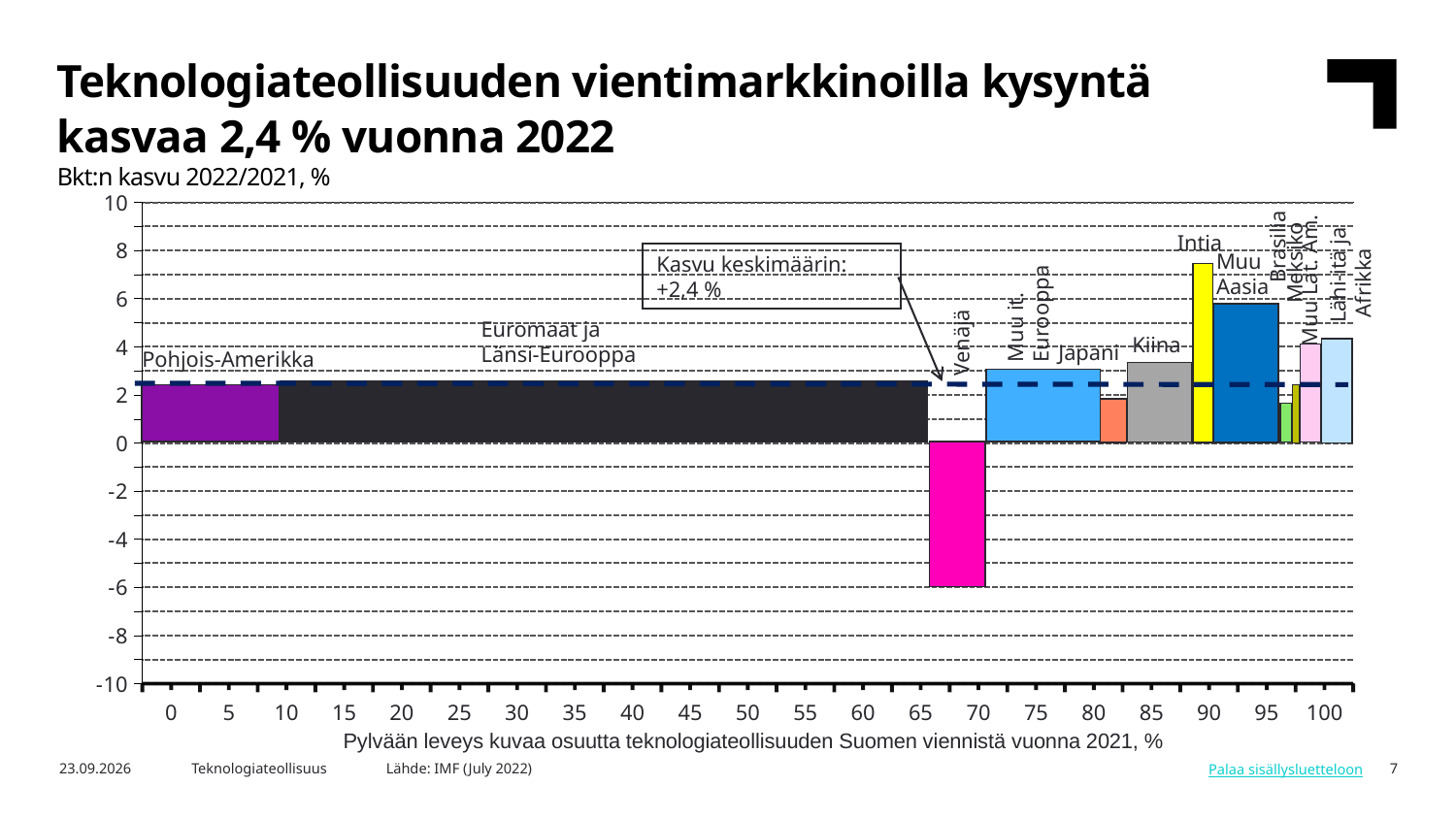
Is the value for Kiina greater or less than 4? less Is the value for Intia greater or less than 6? greater Is the value for Venäjä greater or less than -4? less Which has the larger GDP growth, Kiina or Japani? Kiina What average growth (Kasvu keskimäärin) is printed on the chart? +2,4 % What kind of chart is shown on the slide? bar chart Which has the larger GDP growth, Intia or Muu Aasia? Intia Which region has the highest GDP growth in the chart? Intia Which region has the lowest GDP growth in the chart? Venäjä According to the note below the x axis, what does the width of each bar represent? Share of Finnish technology industry exports in 2021